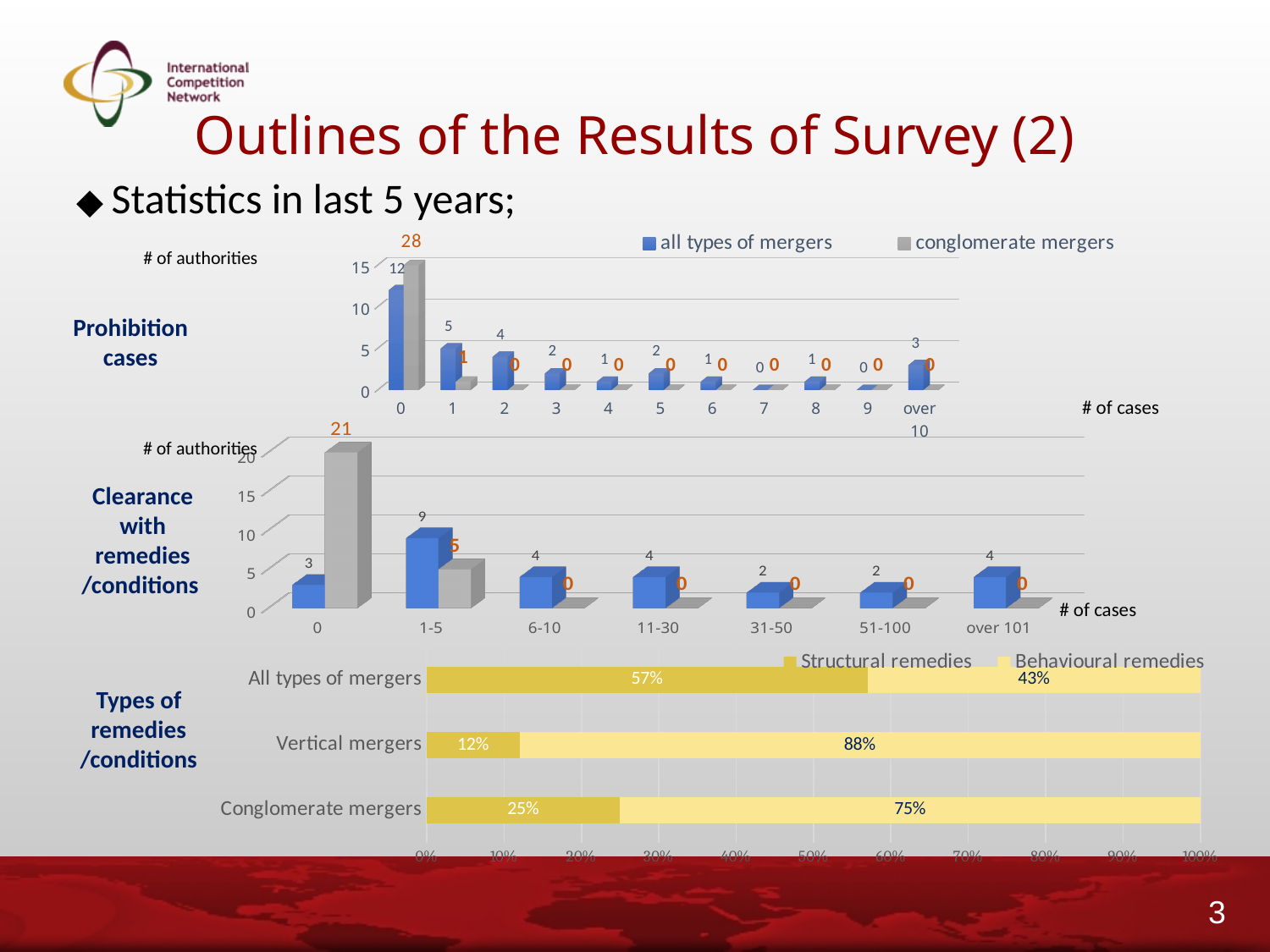
In the Prohibition cases chart, what is the value for conglomerate mergers at 0 cases? 28 In the Clearance with remedies/conditions chart, how many categories are shown on the x axis? 7 In the Prohibition cases chart, what is the value for all types of mergers at over 10 cases? 3 In the Types of remedies/conditions chart, how many series does the legend list? 2 In the Types of remedies/conditions chart, what share of Vertical mergers is Behavioural remedies? 88% In the Prohibition cases chart, what is the value for all types of mergers at 0 cases? 12 In the Clearance with remedies/conditions chart, what is the value for conglomerate mergers at 1-5 cases? 5 In the Types of remedies/conditions chart, which is larger for All types of mergers: Structural remedies or Behavioural remedies? Structural remedies In the Clearance with remedies/conditions chart, which category has the highest value for all types of mergers? 1-5 In the Clearance with remedies/conditions chart, what is the value for conglomerate mergers at 0 cases? 21 In the Prohibition cases chart, how many categories are shown on the x axis? 11 In the Prohibition cases chart, what is the difference between conglomerate mergers and all types of mergers at 0 cases? 16